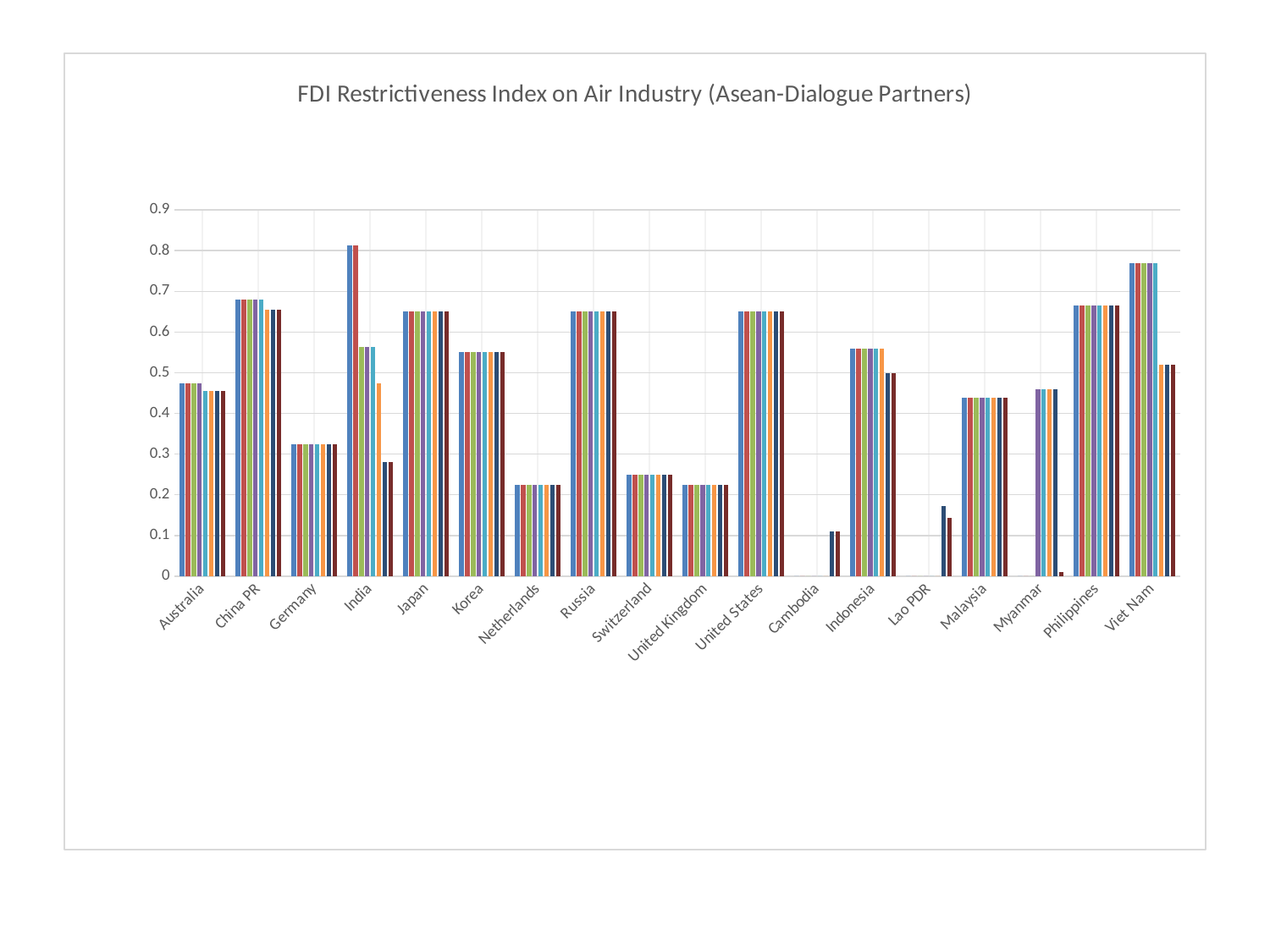
Which country has higher values, Philippines or Malaysia? Philippines Which country has the single tallest bar in the chart? India What is the title of the chart? FDI Restrictiveness Index on Air Industry (Asean-Dialogue Partners) Are the values for Netherlands greater or less than 0.3? less How many countries are shown on the x axis of the chart? 18 Which country has higher values, Japan or Germany? Japan Are the values for Malaysia greater or less than 0.4? greater What kind of chart is shown on the slide? bar chart Are the values for Japan greater or less than 0.6? greater Which country has higher values, Korea or Netherlands? Korea